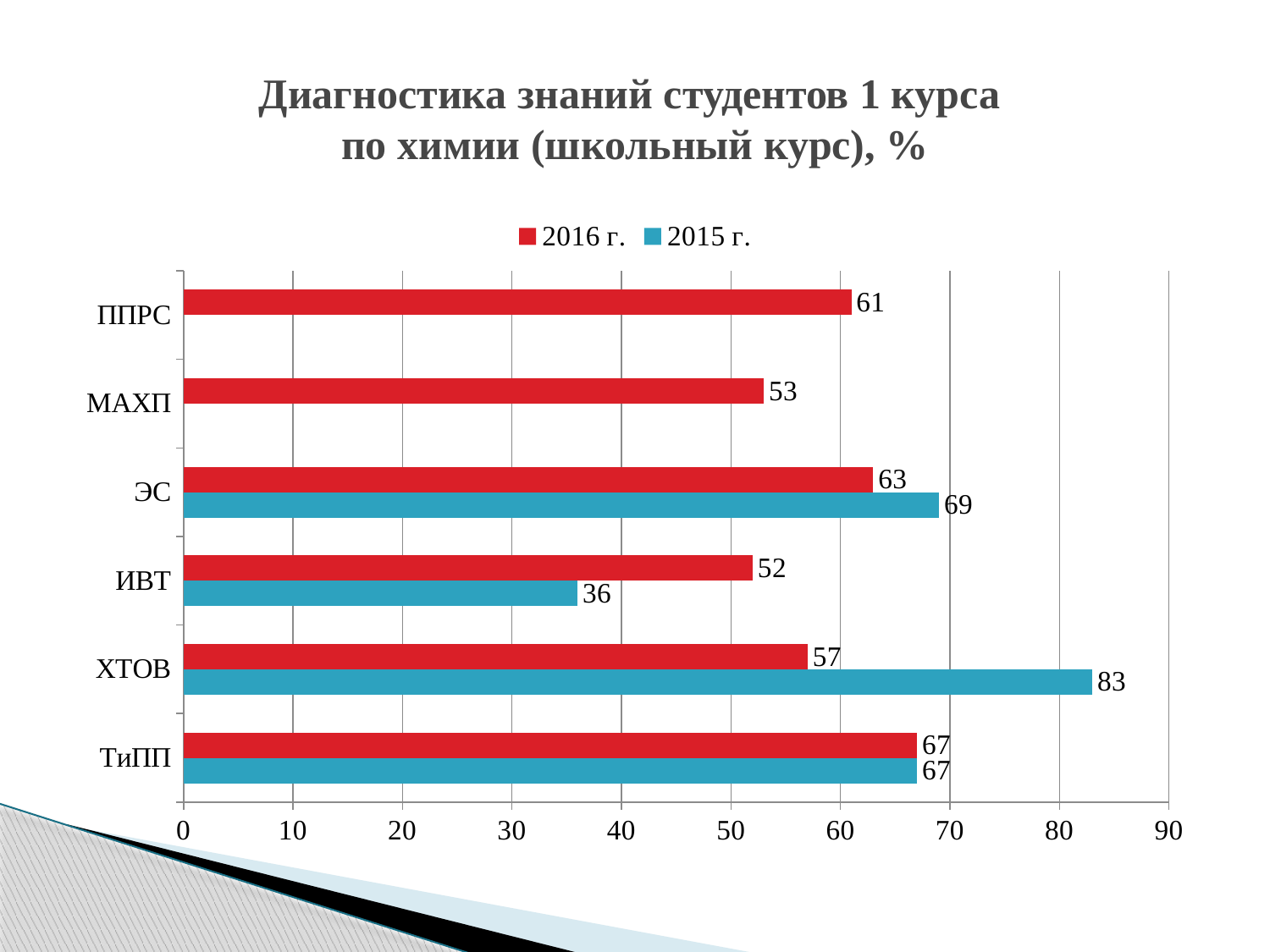
Which is larger for ЭС: the 2016 г. value or the 2015 г. value? 2015 г. What is the difference between the 2015 г. and 2016 г. values for ХТОВ? 26 Is the 2016 г. value for МАХП greater or less than 60? less Which category has the highest 2015 г. value? ХТОВ Which category has the lowest 2016 г. value? ИВТ How many series does the legend list? 2 What is the 2016 г. value for ППРС? 61 How many categories are shown on the y axis? 6 Which colour represents the 2015 г. series? blue What is the 2016 г. value for ХТОВ? 57 What is the 2015 г. value for ИВТ? 36 What kind of chart is shown on the slide? bar chart